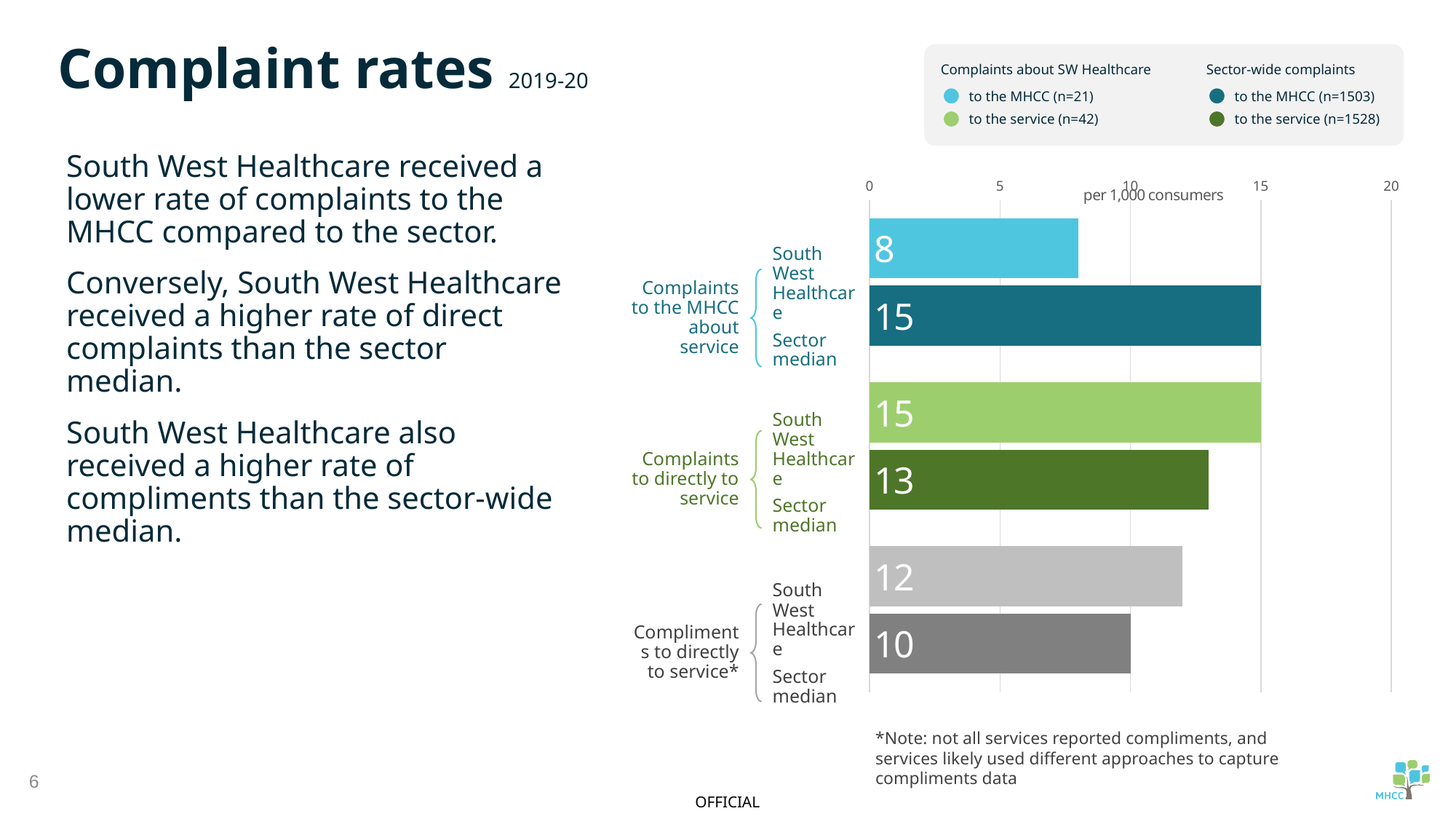
Which bar has the lowest value on the chart? South West Healthcare, complaints to the MHCC about service What is the sector median rate of compliments made directly to the service? 10 What is the rate of complaints to the MHCC about service for South West Healthcare? 8 For complaints made directly to the service, which is larger: South West Healthcare or the sector median? South West Healthcare According to the legend, how many sector-wide complaints were made to the service? n=1528 What is the difference between South West Healthcare and the sector median for compliments made directly to the service? 2 What is the difference between the sector median and South West Healthcare for complaints to the MHCC about service? 7 What is the rate of complaints made directly to the service for South West Healthcare? 15 What is the sector median rate of complaints to the MHCC about service? 15 What unit is the horizontal axis of the chart measured in? per 1,000 consumers How many bars are plotted on the chart? 6 What type of chart is shown on the slide? Bar chart